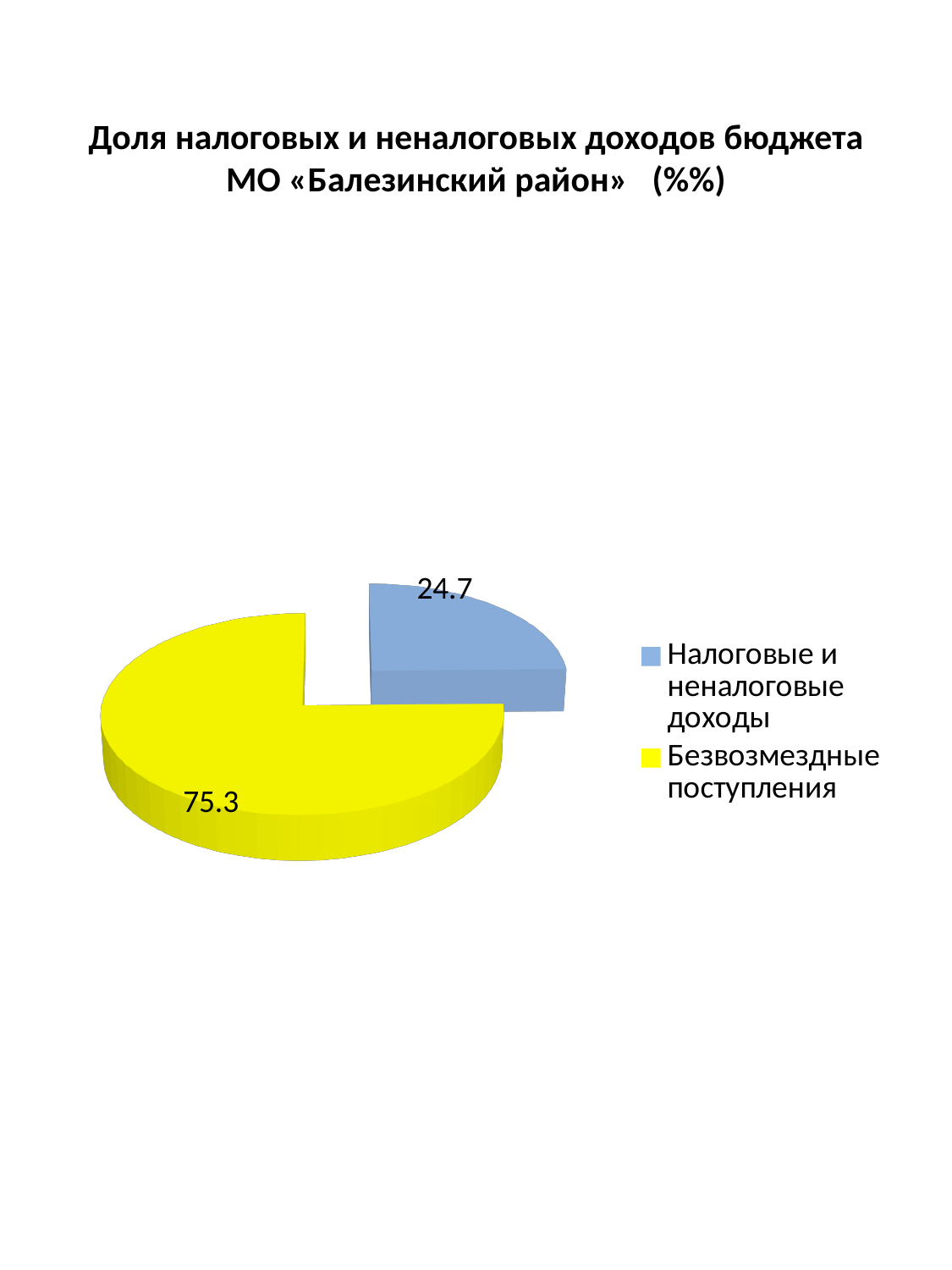
What is the value for Налоговые и неналоговые доходы? 24.7 Which is larger: Налоговые и неналоговые доходы or Безвозмездные поступления? Безвозмездные поступления What type of chart is shown on the slide? Pie chart What is the difference between the values for Безвозмездные поступления and Налоговые и неналоговые доходы? 50.6 Which category has the largest share of the pie? Безвозмездные поступления What is the total of the two slice values? 100 Which category has the smallest share of the pie? Налоговые и неналоговые доходы What colour is the slice for Налоговые и неналоговые доходы? Blue How many slices does the pie chart have? 2 How many entries does the legend list? 2 What is the value for Безвозмездные поступления? 75.3 What colour is the slice for Безвозмездные поступления? Yellow